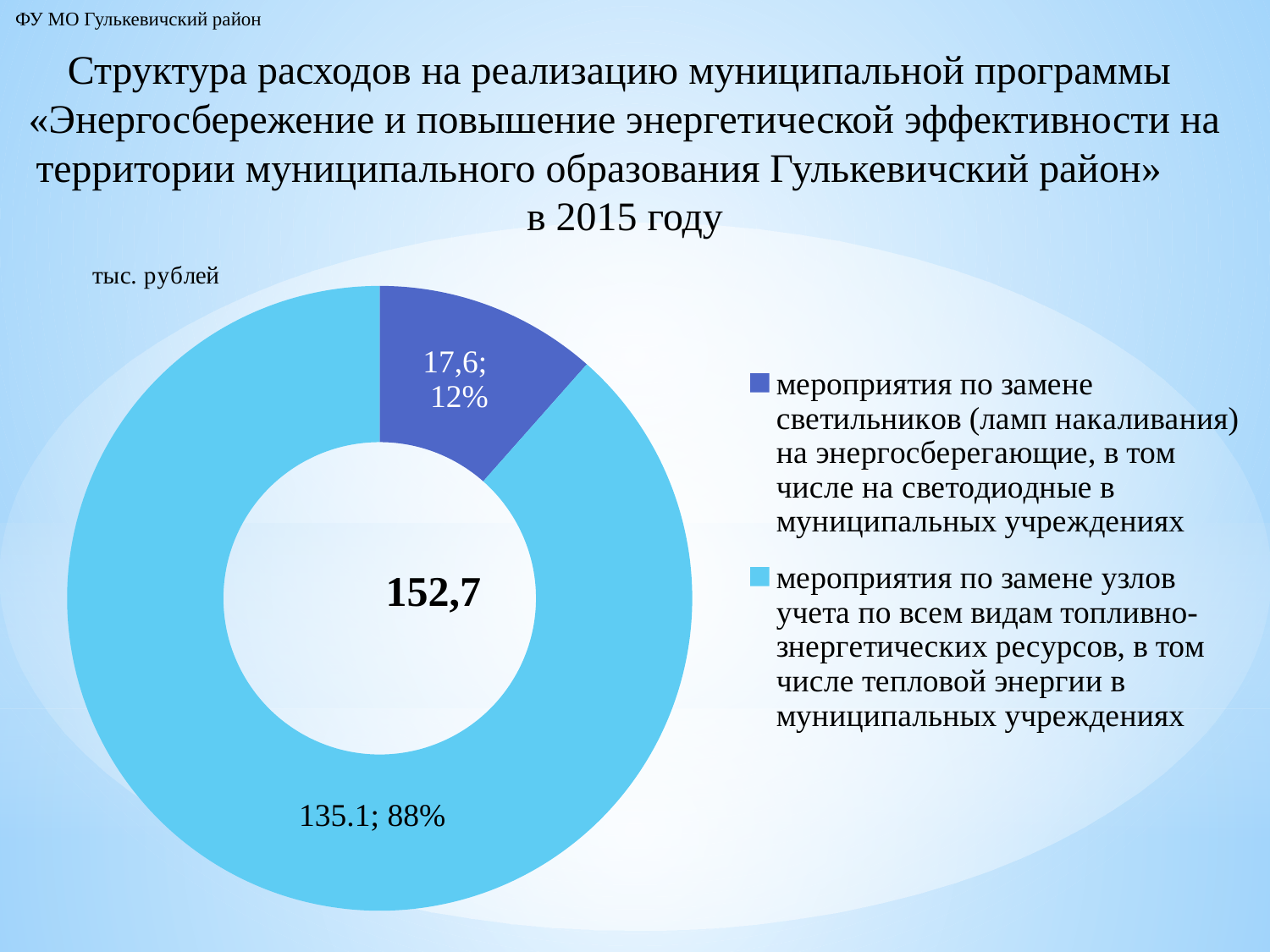
What is the total value shown in the centre of the chart? 152,7 In what units are the values on the chart expressed? тыс. рублей Which category has the smallest share of expenditures? мероприятия по замене светильников (ламп накаливания) на энергосберегающие What type of chart is shown on the slide? doughnut (pie) chart What is the value for the measures to replace metering units (мероприятия по замене узлов учета) for fuel and energy resources? 135.1 What share of the total do the measures to replace lamps (мероприятия по замене светильников) account for? 12% What share of the total do the measures to replace metering units (мероприятия по замене узлов учета) account for? 88% Which category has the largest share of expenditures? мероприятия по замене узлов учета по всем видам топливно-энергетических ресурсов What is the difference between the value for replacing metering units (135.1) and the value for replacing lamps (17,6)? 117.5 What is the value for the measures to replace lamps (мероприятия по замене светильников) with energy-saving ones? 17,6 Which colour represents the measures to replace lamps (мероприятия по замене светильников)? dark blue (purple-blue) How many categories does the chart show? 2